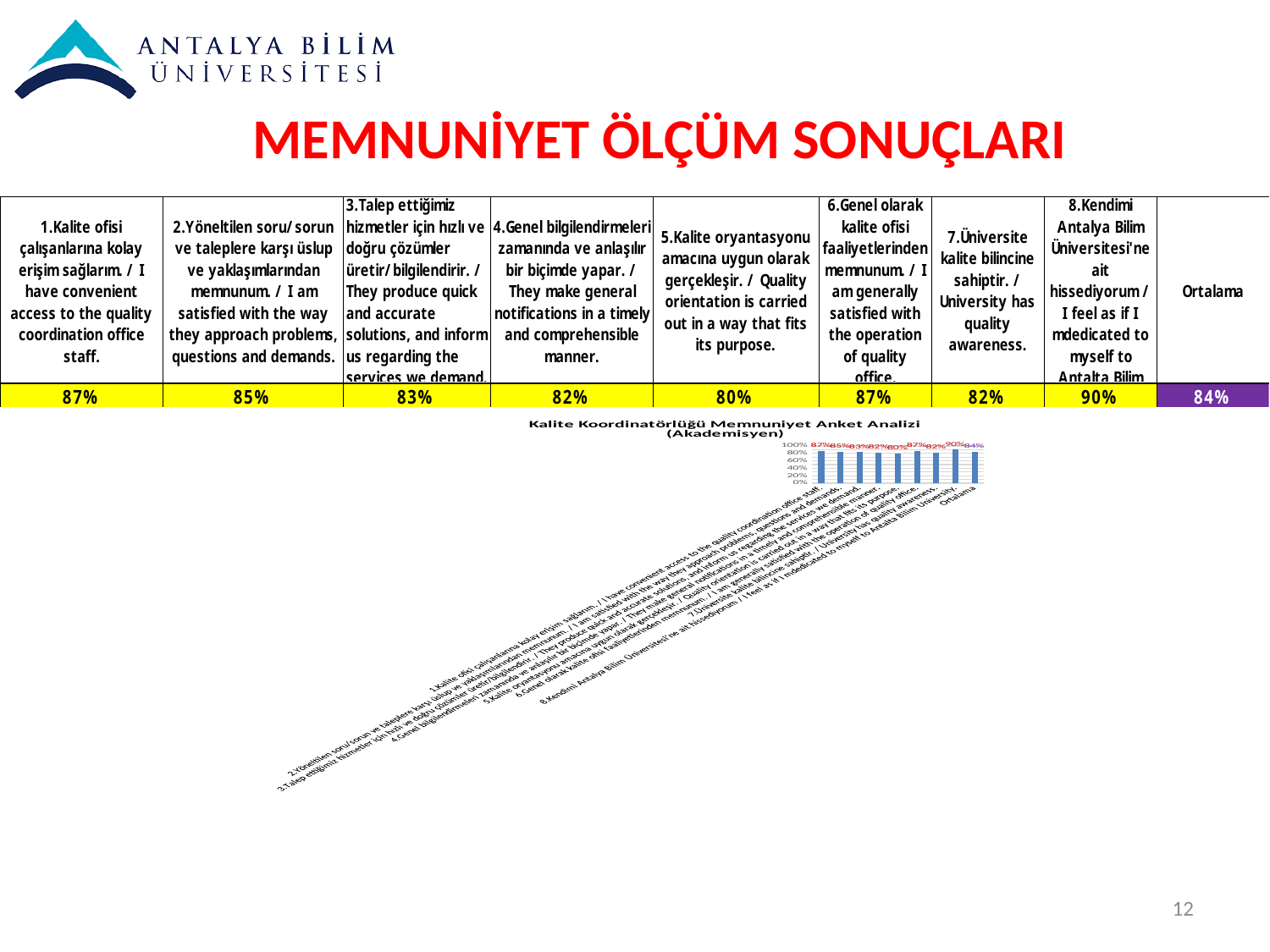
What is the value shown for item 8 (Kendimi Antalya Bilim Üniversitesi'ne ait hissediyorum) in the chart? 90% Which item has the lowest value in the chart? 5.Kalite oryantasyonu amacına uygun olarak gerçekleşir What is the value shown for the 'Ortalama' bar in the chart? 84% What is the difference between the value for item 8 and the value for item 5 in the chart? 10% What is the maximum value shown on the chart's vertical axis? 100% What type of chart is shown on the slide? bar chart Which is larger in the chart: the value for item 1 (Kalite ofisi çalışanlarına kolay erişim sağlarım) or the value for item 4 (Genel bilgilendirmeleri zamanında ve anlaşılır bir biçimde yapar)? item 1 Which item has the highest value in the chart? 8.Kendimi Antalya Bilim Üniversitesi'ne ait hissediyorum What is the title of the chart on the slide? Kalite Koordinatörlüğü Memnuniyet Anket Analizi (Akademisyen) Is the value for item 2 (Yöneltilen soru/sorun ve taleplere karşı üslup ve yaklaşımlarından memnunum) greater or less than 80%? greater What is the value shown for item 5 (Kalite oryantasyonu amacına uygun olarak gerçekleşir) in the chart? 80% How many bars are plotted in the chart? 9